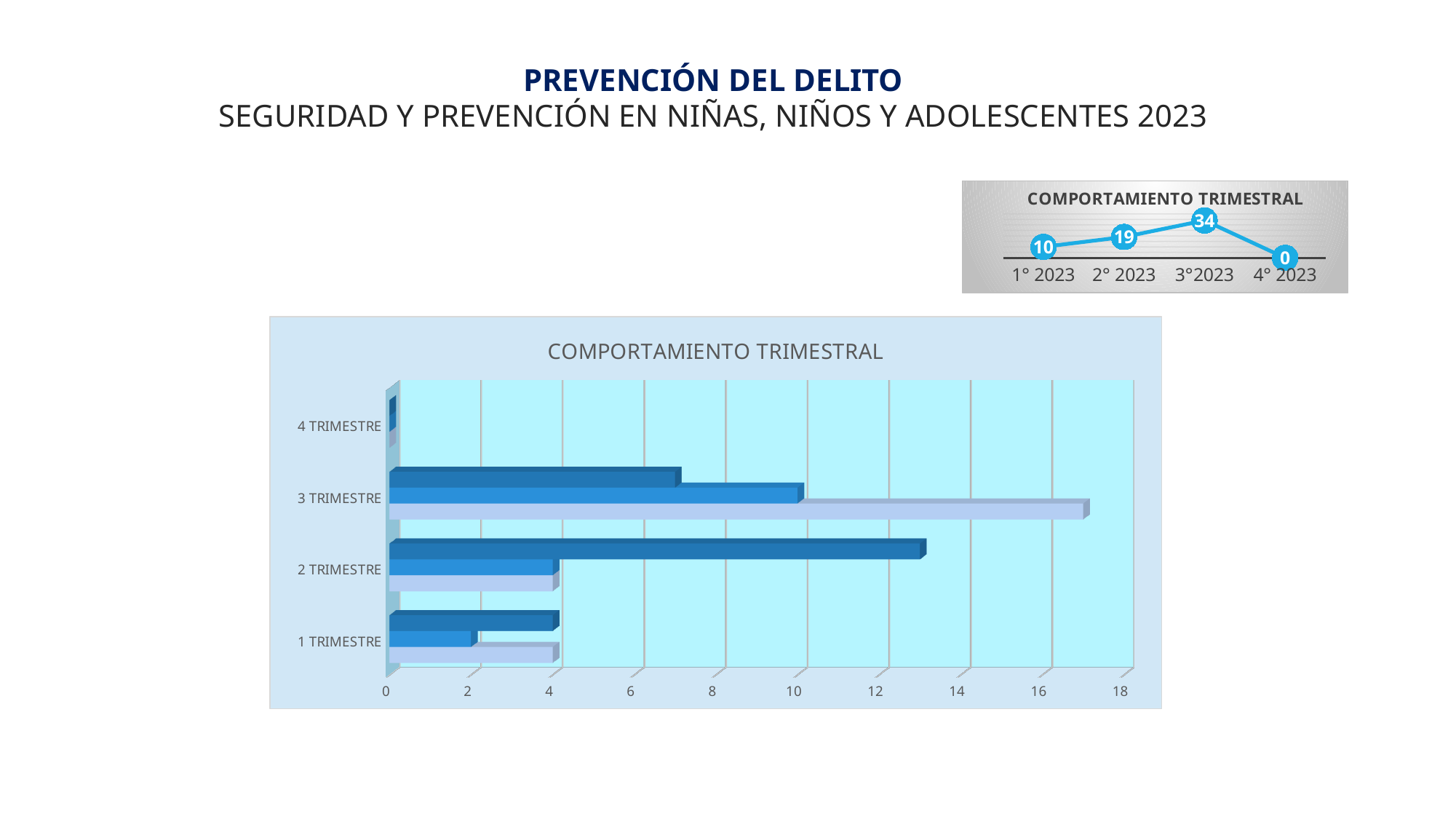
In the line chart at the top right, does the value rise or fall from 3°2023 to 4° 2023? fall What kind of chart is the large chart in the lower part of the slide? bar chart In the line chart at the top right, which quarter has the lowest value? 4° 2023 In the line chart at the top right, what is the value for 3°2023? 34 In the line chart at the top right, how many data points are plotted? 4 In the line chart at the top right, what is the value for 4° 2023? 0 In the line chart titled COMPORTAMIENTO TRIMESTRAL at the top right, what is the value for 1° 2023? 10 In the line chart at the top right, which quarter has the highest value? 3°2023 In the line chart at the top right, what is the difference between the values for 3°2023 and 2° 2023? 15 In the large bar chart, how many categories are shown on the vertical axis? 4 In the large bar chart, is the longest bar for 3 TRIMESTRE greater or less than 16? greater In the line chart at the top right, what is the value for 2° 2023? 19